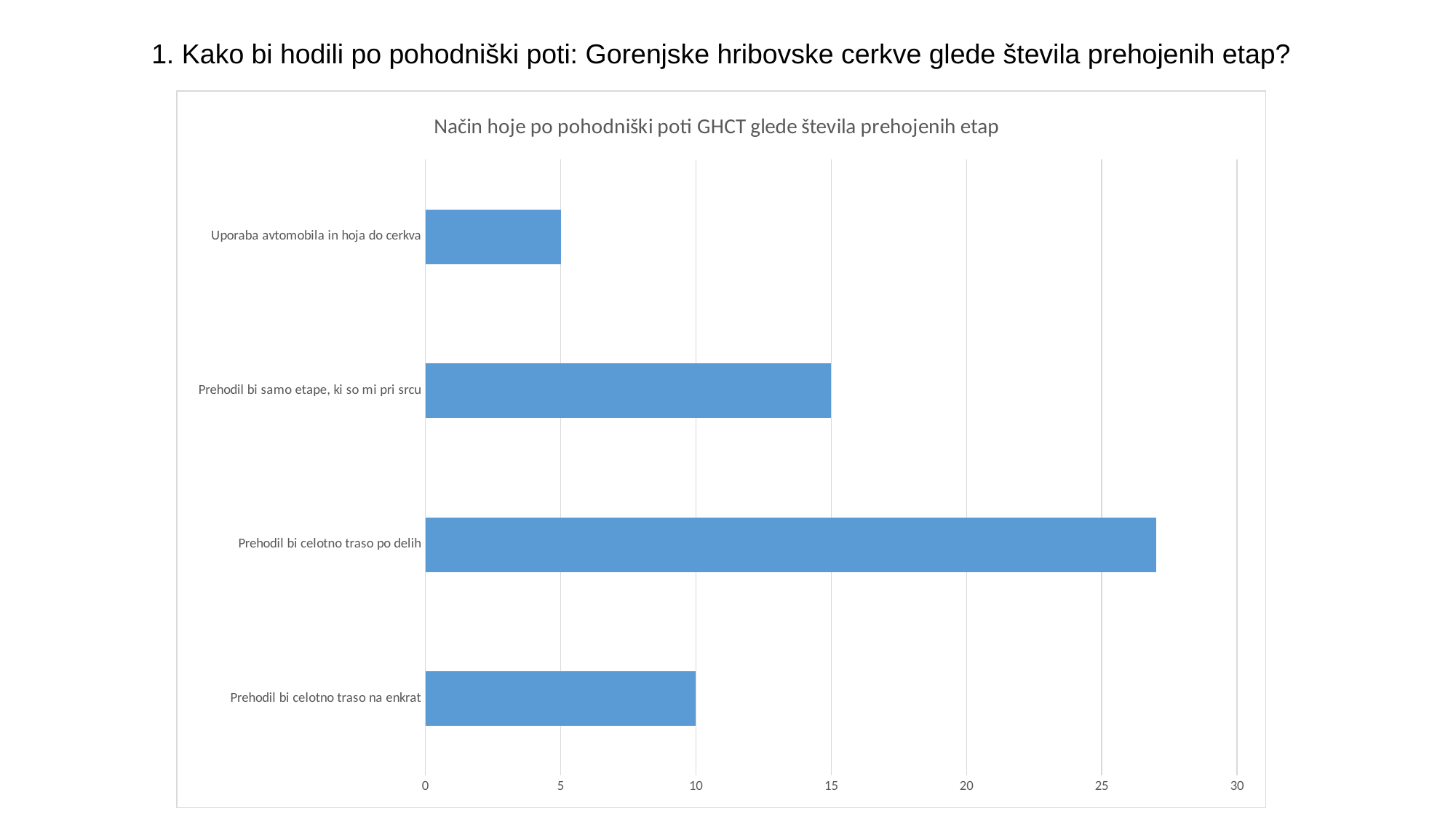
Which category has the lowest value? Uporaba avtomobila in hoja do cerkva Is the value for "Prehodil bi celotno traso po delih" greater or less than 25? greater Is the value for "Prehodil bi celotno traso po delih" greater or less than 30? less What is the value for "Uporaba avtomobila in hoja do cerkva"? 5 What is the value for "Prehodil bi samo etape, ki so mi pri srcu"? 15 Which category has the highest value? Prehodil bi celotno traso po delih What kind of chart is shown on the slide? bar chart What is the title of the chart? Način hoje po pohodniški poti GHCT glede števila prehojenih etap Which is larger: the value for "Prehodil bi celotno traso na enkrat" or the value for "Uporaba avtomobila in hoja do cerkva"? Prehodil bi celotno traso na enkrat What is the value for "Prehodil bi celotno traso na enkrat"? 10 What is the difference between the values for "Prehodil bi samo etape, ki so mi pri srcu" and "Prehodil bi celotno traso na enkrat"? 5 How many categories are shown in the chart? 4